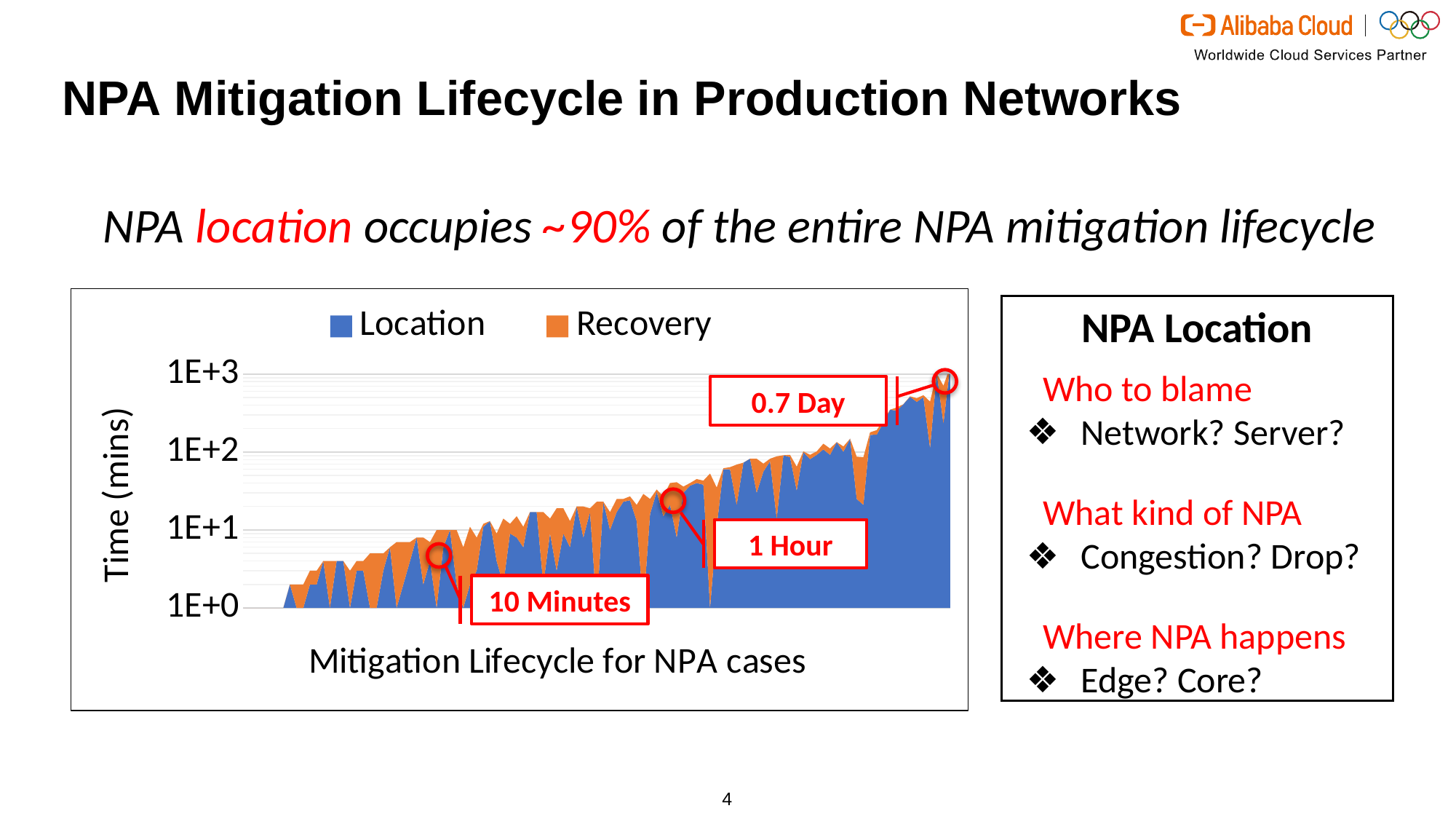
Do the stacked values rise or fall moving left to right along the x axis of the chart? Rise What time value is annotated at the leftmost circled point of the chart? 10 Minutes What is the highest tick value shown on the y axis of the chart? 1E+3 What is the lowest tick value shown on the y axis of the chart? 1E+0 What is the label on the y axis of the chart? Time (mins) What time value is annotated at the middle circled point of the chart? 1 Hour What kind of chart is shown on the slide? Stacked area chart Is the stacked value at the far right end of the chart greater or less than 1E+2? greater What are the two series named in the chart legend? Location and Recovery What time value is annotated at the rightmost circled point of the chart? 0.7 Day Which series, Location or Recovery, occupies the larger area of the chart? Location How many series does the chart legend list? 2